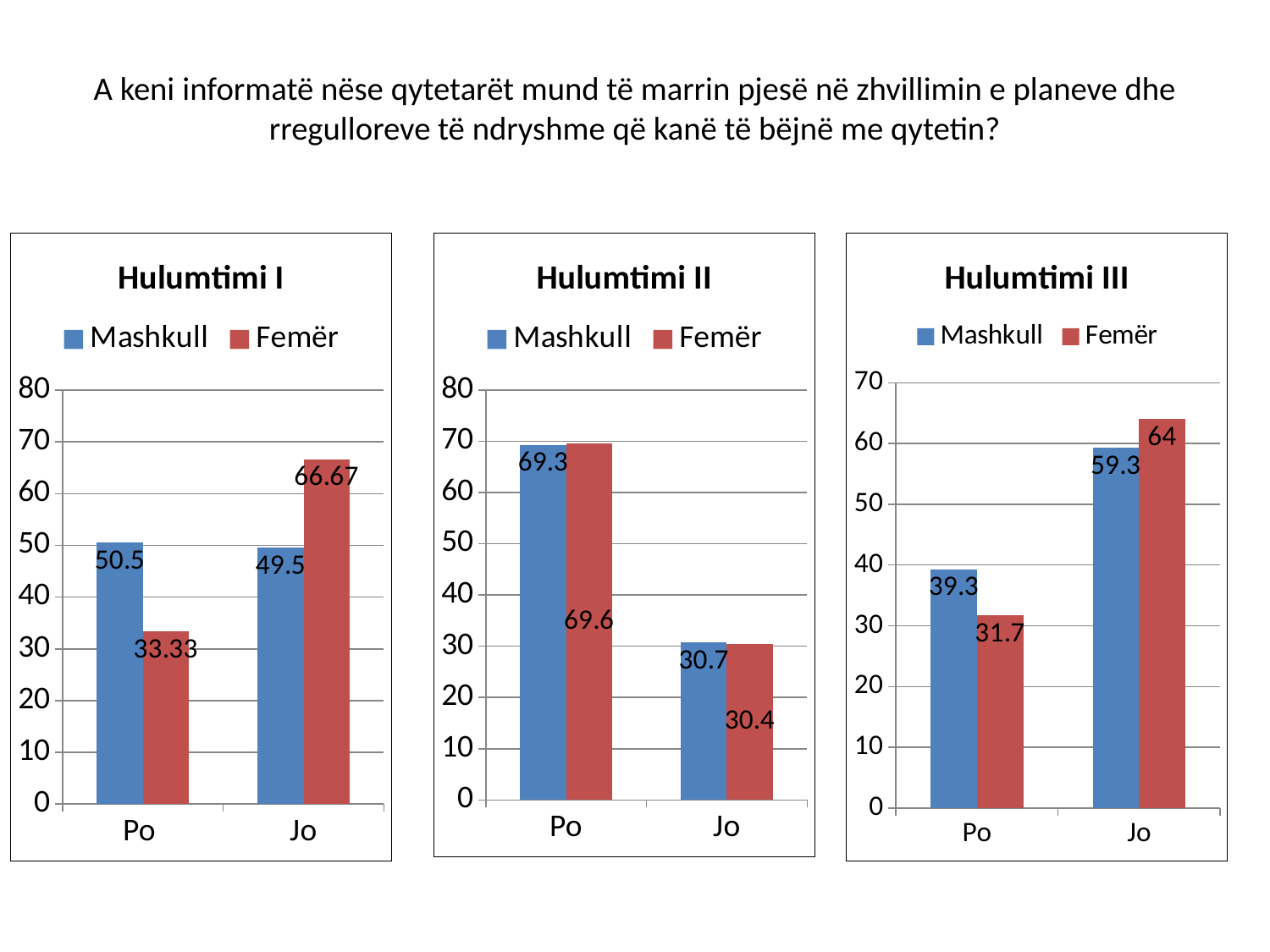
In the Hulumtimi III chart, what is the difference between the Mashkull and Femër values for Po? 7.6 In the Hulumtimi III chart, what is the value for Mashkull in the Po category? 39.3 In the Hulumtimi III chart, which is larger in the Jo category, Mashkull or Femër? Femër In the Hulumtimi II chart, which category has the lowest Femër value? Jo In the Hulumtimi II chart, what is the value for Femër in the Po category? 69.6 In the Hulumtimi II chart, what is the value for Mashkull in the Jo category? 30.7 How many series does the legend of the Hulumtimi I chart list? 2 In the Hulumtimi I chart, what is the difference between the Femër values for Jo and Po? 33.34 In the Hulumtimi III chart, what is the value for Femër in the Jo category? 64 In the Hulumtimi I chart, what is the value for Femër in the Jo category? 66.67 In the Hulumtimi I chart, what is the value for Mashkull in the Po category? 50.5 What kind of chart is the Hulumtimi II chart? Bar chart